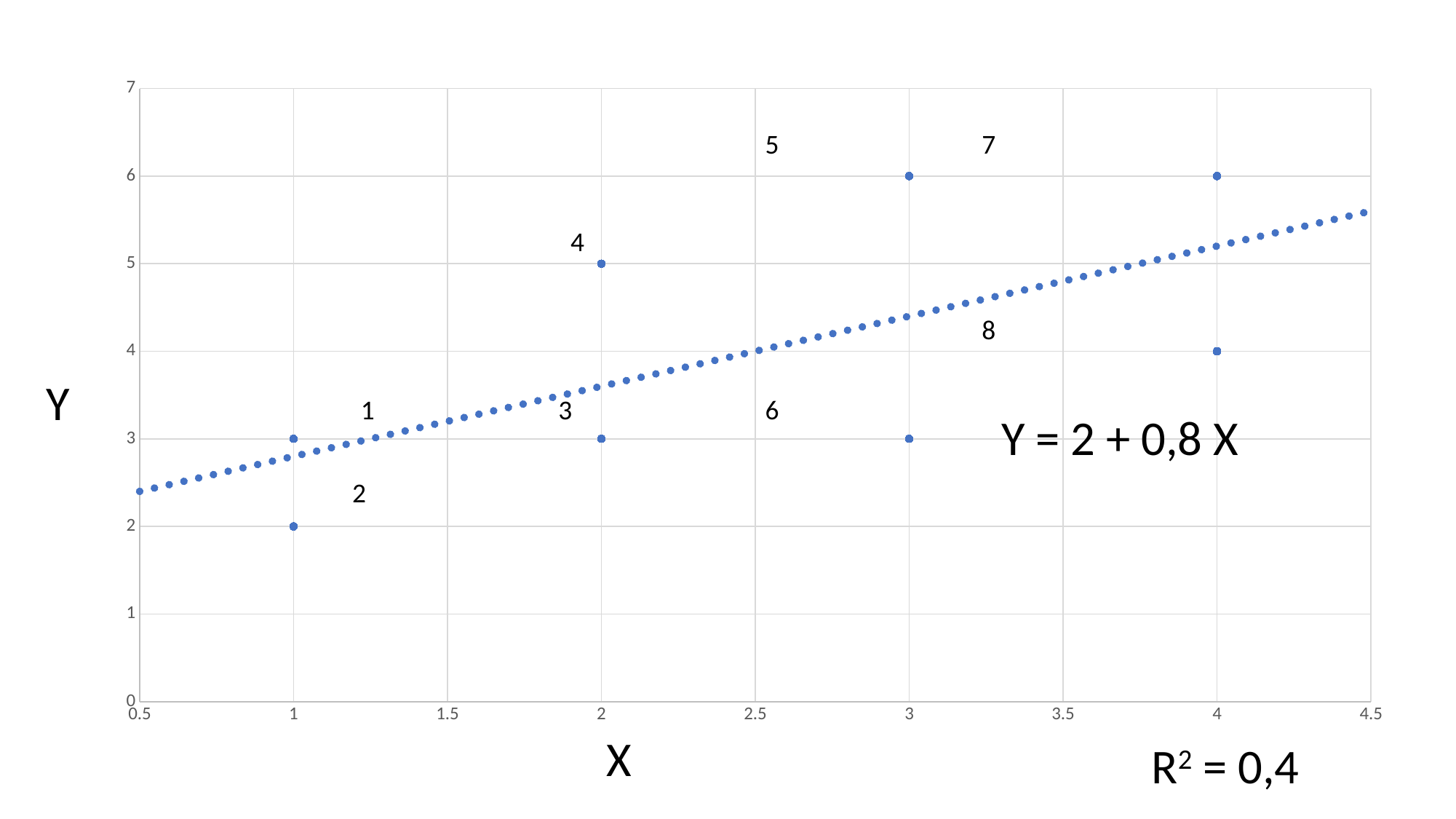
Which labelled point has the lowest Y value? 2 Which point has the larger Y value, point 4 or point 3? 4 What is the difference in Y between the points labelled 7 and 8? 2 What is the Y value of the point labelled 6? 3 What R² value is printed on the slide? 0,4 What regression equation is printed on the chart? Y = 2 + 0,8 X What is the X value of the point labelled 8? 4 What kind of chart is shown on the slide? scatter plot What is the Y value of the point labelled 2? 2 How many data points are plotted on the chart? 8 Does the dotted trend line rise or fall as X increases? rise What is the Y value of the point labelled 4? 5